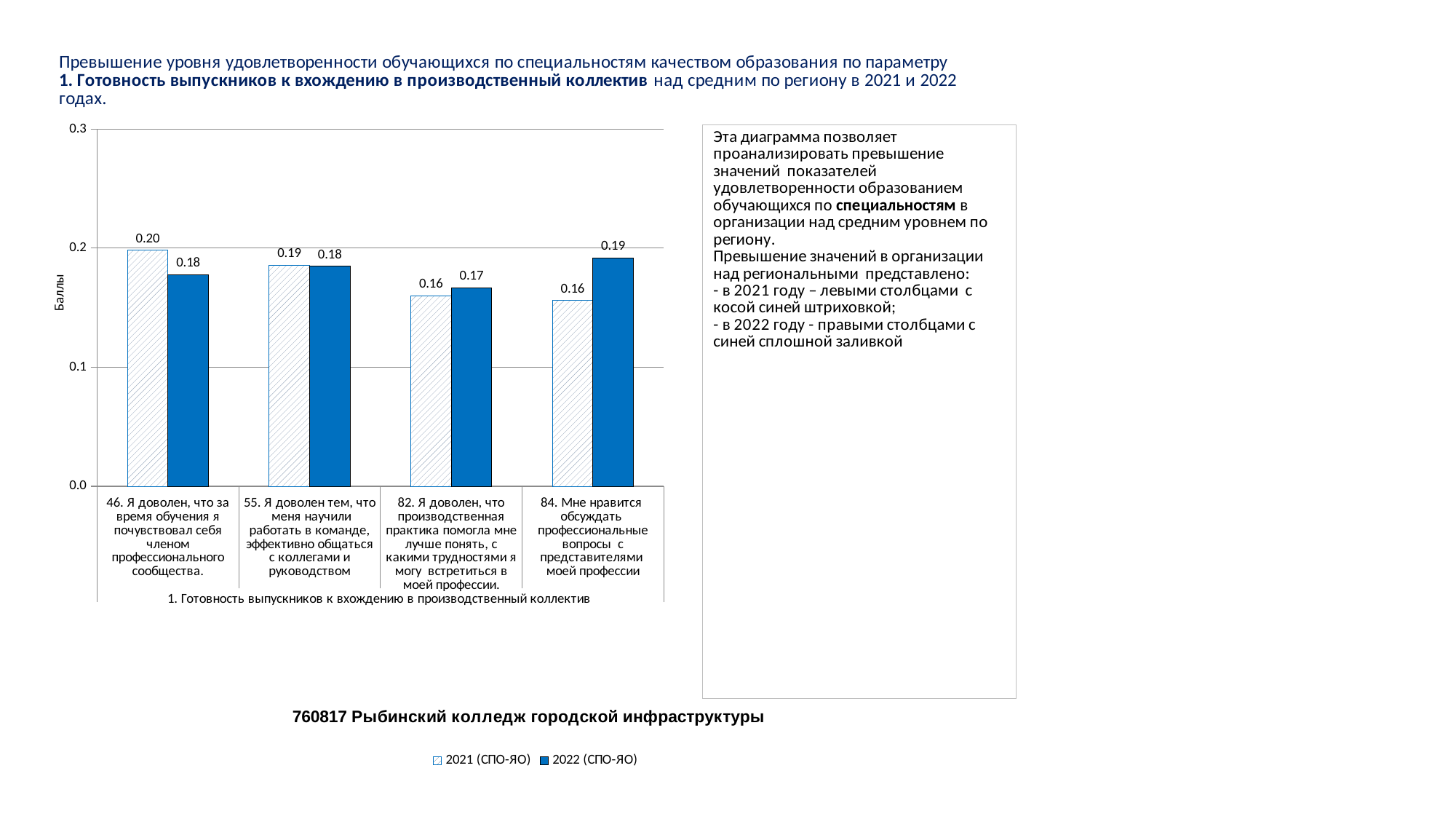
How many series does the legend list? 2 What is the 2021 (СПО-ЯО) value for category 46 (Я доволен, что за время обучения я почувствовал себя членом профессионального сообщества)? 0.20 What is the 2022 (СПО-ЯО) value for category 84 (Мне нравится обсуждать профессиональные вопросы с представителями моей профессии)? 0.19 What kind of chart is shown on the slide? bar chart Is the 2021 (СПО-ЯО) value for category 46 greater or less than 0.1? greater Which category has the lowest 2022 (СПО-ЯО) value? 82. Я доволен, что производственная практика помогла мне лучше понять, с какими трудностями я могу встретиться в моей профессии. What is the 2022 (СПО-ЯО) value for category 82 (Я доволен, что производственная практика помогла мне лучше понять...)? 0.17 Which category has the highest 2021 (СПО-ЯО) value? 46. Я доволен, что за время обучения я почувствовал себя членом профессионального сообщества. What is the difference between the 2021 and 2022 values for category 46? 0.02 How many categories are shown on the x axis of the chart? 4 What is the label of the vertical axis of the chart? Баллы For category 84, which series has the larger value, 2021 (СПО-ЯО) or 2022 (СПО-ЯО)? 2022 (СПО-ЯО)